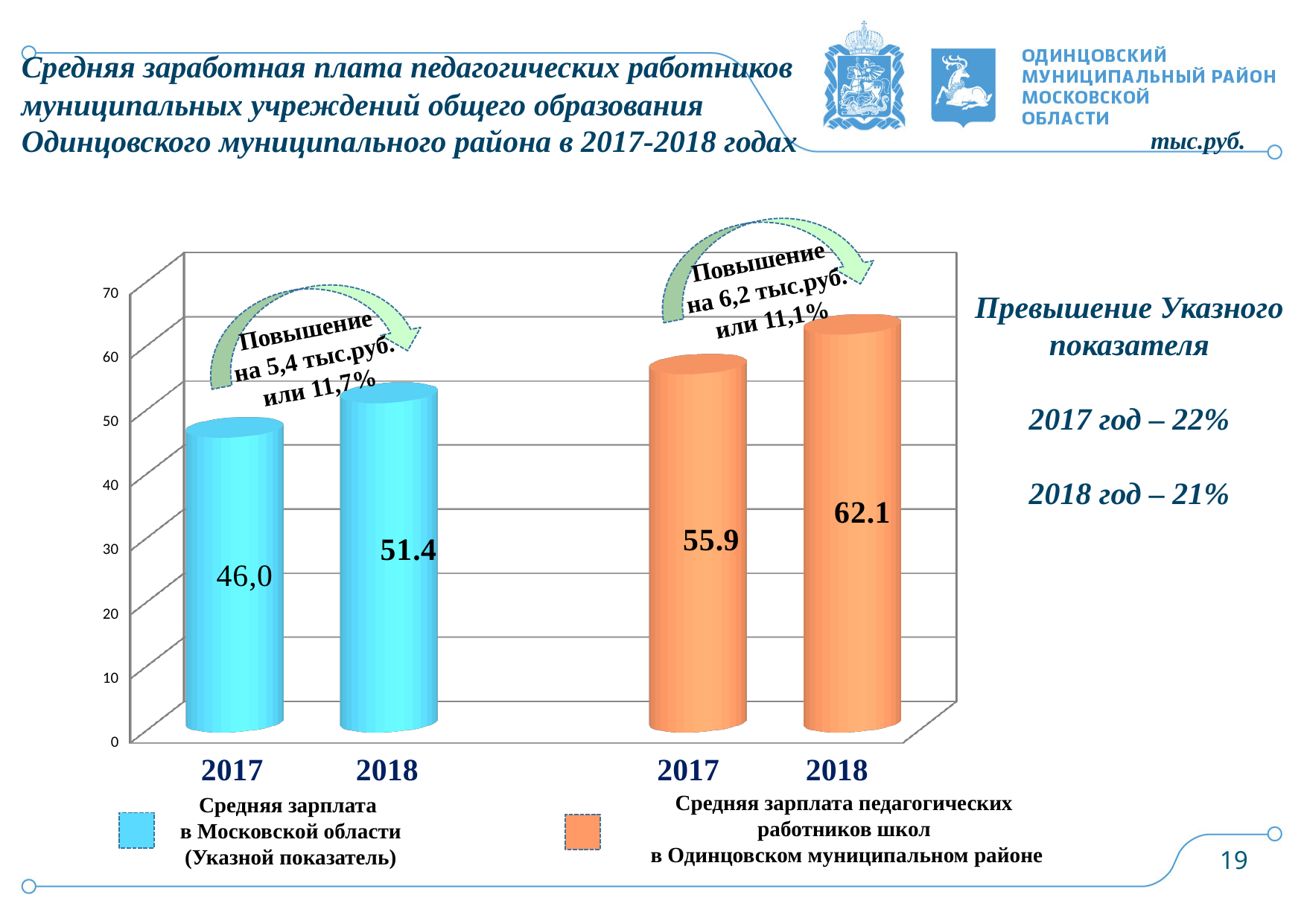
How many series does the legend list? 2 By how much did the average salary of teaching staff in the Odintsovo municipal district increase from 2017 to 2018? 6.2 What is the average salary in the Moscow region (Указной показатель) for 2018? 51.4 Which bar has the lowest value on the chart? 2017, Средняя зарплата в Московской области (46,0) Which bar has the highest value on the chart? 2018, Средняя зарплата педагогических работников школ в Одинцовском муниципальном районе (62.1) What type of chart is shown on the slide? Bar chart What is the difference between the Odintsovo district teachers' salary and the Moscow region indicator in 2017? 9.9 Which is larger in 2018: the Moscow region indicator or the Odintsovo district teachers' salary? Odintsovo district teachers' salary (62.1) How many bars are plotted on the chart? 4 What is the average salary of teaching staff in schools of the Odintsovo municipal district for 2017? 55.9 What is the average salary in the Moscow region (Указной показатель) for 2017? 46,0 What is the average salary of teaching staff in schools of the Odintsovo municipal district for 2018? 62.1